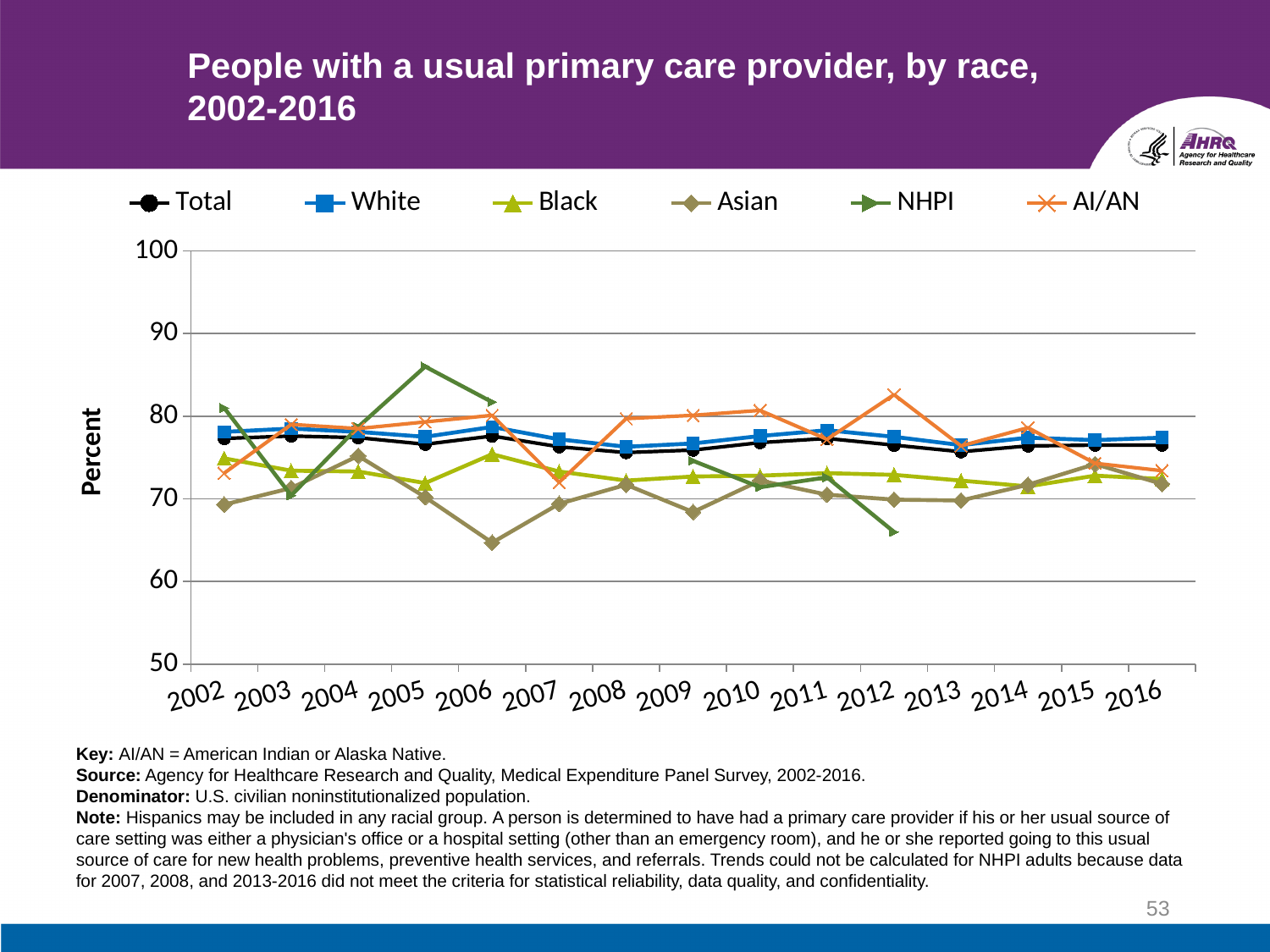
Is the value for Total in 2002 greater or less than 70? greater Which series has the lowest value in 2012? NHPI Which series has the lowest value in 2006? Asian How many years are shown along the x axis? 15 In 2002, which is larger: the value for NHPI or the value for Asian? NHPI How many series does the legend list? 6 Is the value for NHPI in 2005 greater or less than 80? greater Is the value for Asian in 2006 greater or less than 70? less What is the label on the y axis? Percent What kind of chart is shown on the slide? line chart Which series has the highest value in 2005? NHPI